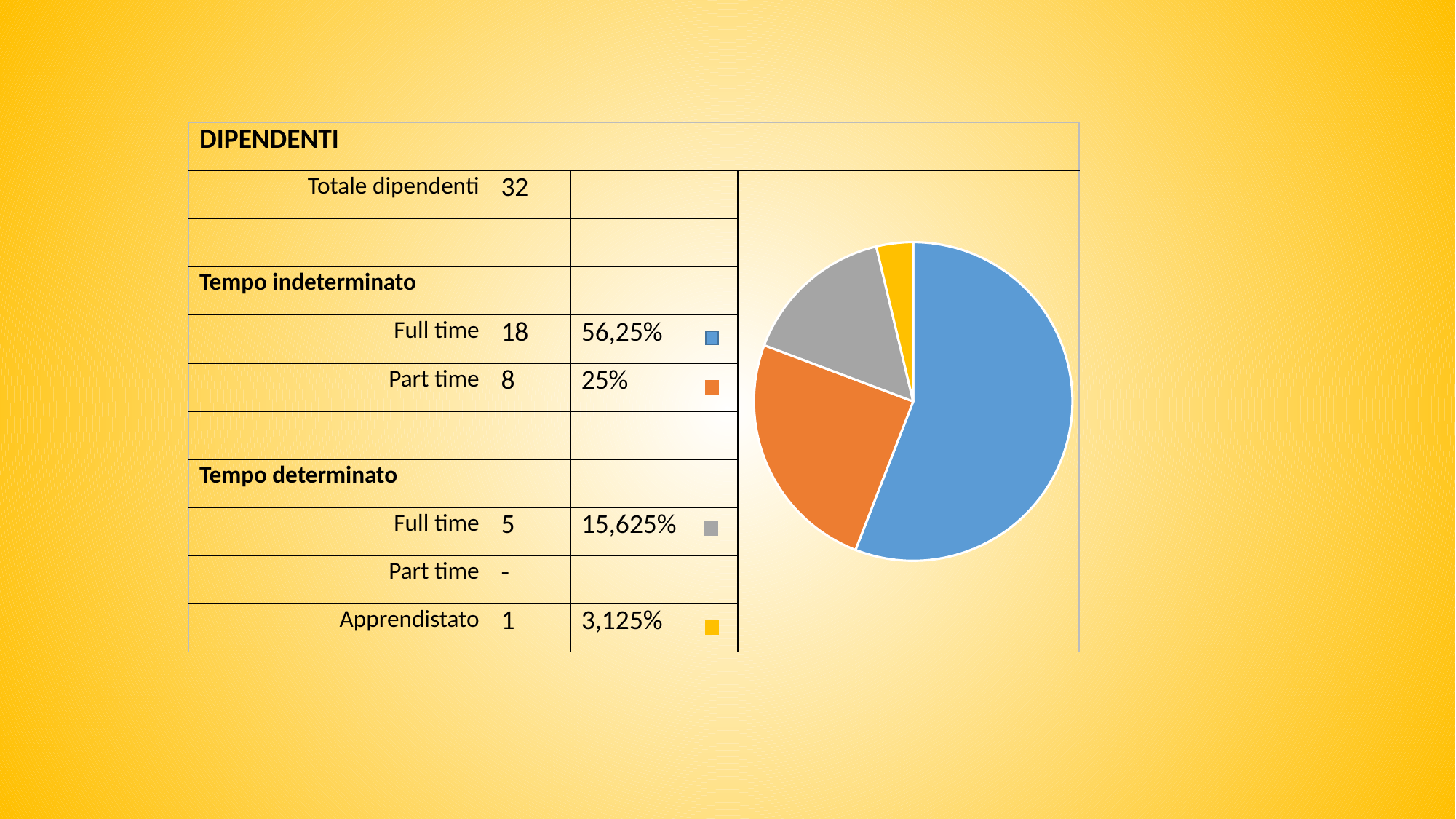
How many employees are in the Apprendistato category? 1 How many employees are in the Tempo indeterminato Full time category? 18 What share of the pie does the orange slice (Tempo indeterminato, Part time) represent? 25% What share of the pie does the yellow slice (Apprendistato) represent? 3,125% What is the difference in employee count between Tempo indeterminato Full time and Tempo indeterminato Part time? 10 What kind of chart is shown on the slide? pie chart What share of the pie does the grey slice (Tempo determinato, Full time) represent? 15,625% Which is larger: the Tempo indeterminato Part time slice or the Tempo determinato Full time slice? Tempo indeterminato Part time Which category has the smallest slice of the pie? Apprendistato How many slices does the pie chart have? 4 Which category has the largest slice of the pie? Tempo indeterminato Full time